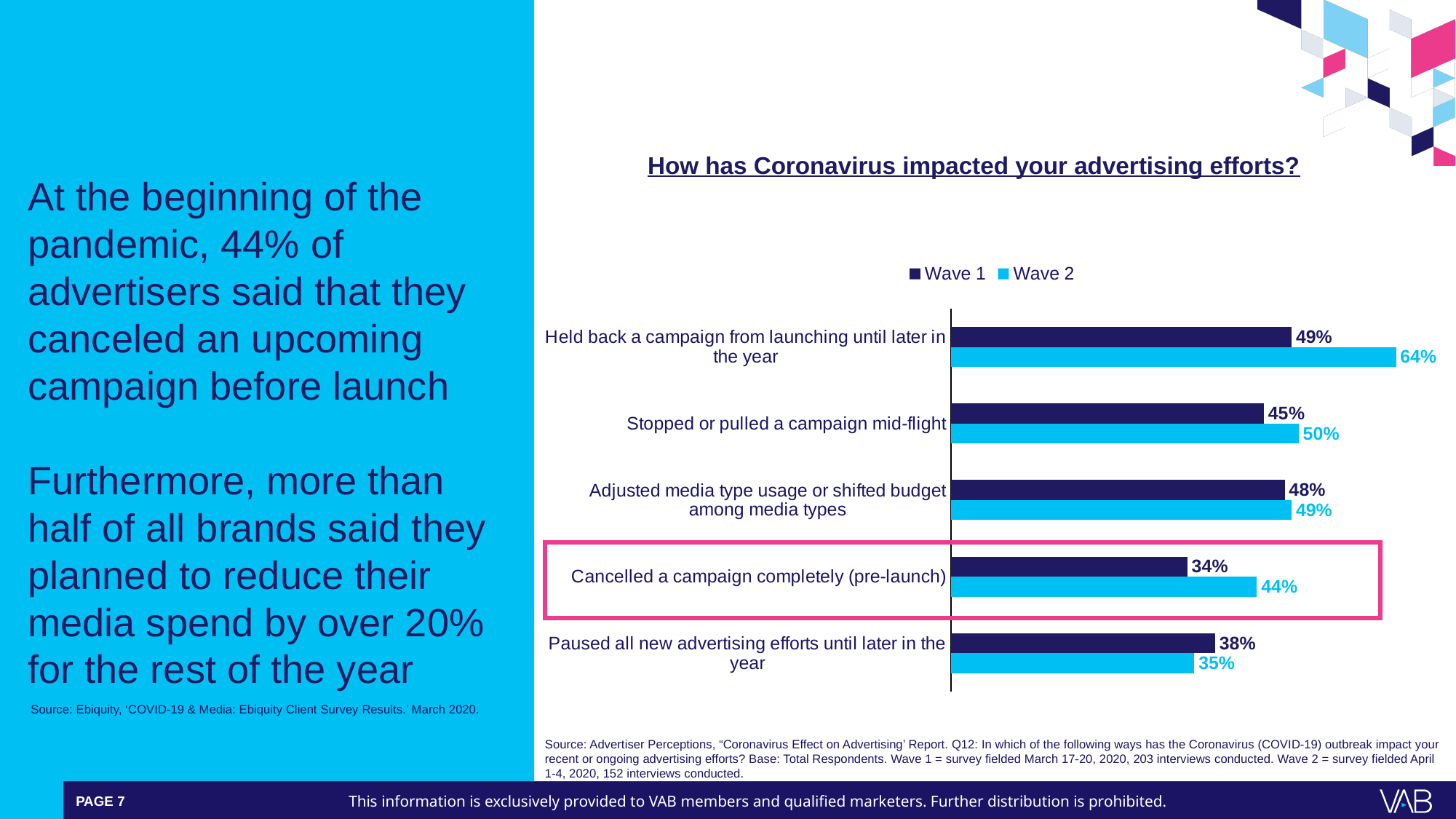
What is the Wave 2 value for 'Stopped or pulled a campaign mid-flight'? 50% How many series does the legend list? 2 What is the Wave 2 value for 'Held back a campaign from launching until later in the year'? 64% Which category has the lowest Wave 1 value? Cancelled a campaign completely (pre-launch) How many categories are shown in the chart? 5 Which category has the highest Wave 2 value? Held back a campaign from launching until later in the year What kind of chart is shown on the slide? Bar chart What is the Wave 1 value for 'Cancelled a campaign completely (pre-launch)'? 34% What is the difference between the Wave 2 and Wave 1 values for 'Cancelled a campaign completely (pre-launch)'? 10% What is the difference between the Wave 2 and Wave 1 values for 'Held back a campaign from launching until later in the year'? 15% For 'Paused all new advertising efforts until later in the year', which is larger: the Wave 1 value or the Wave 2 value? Wave 1 What is the title of the chart? How has Coronavirus impacted your advertising efforts?